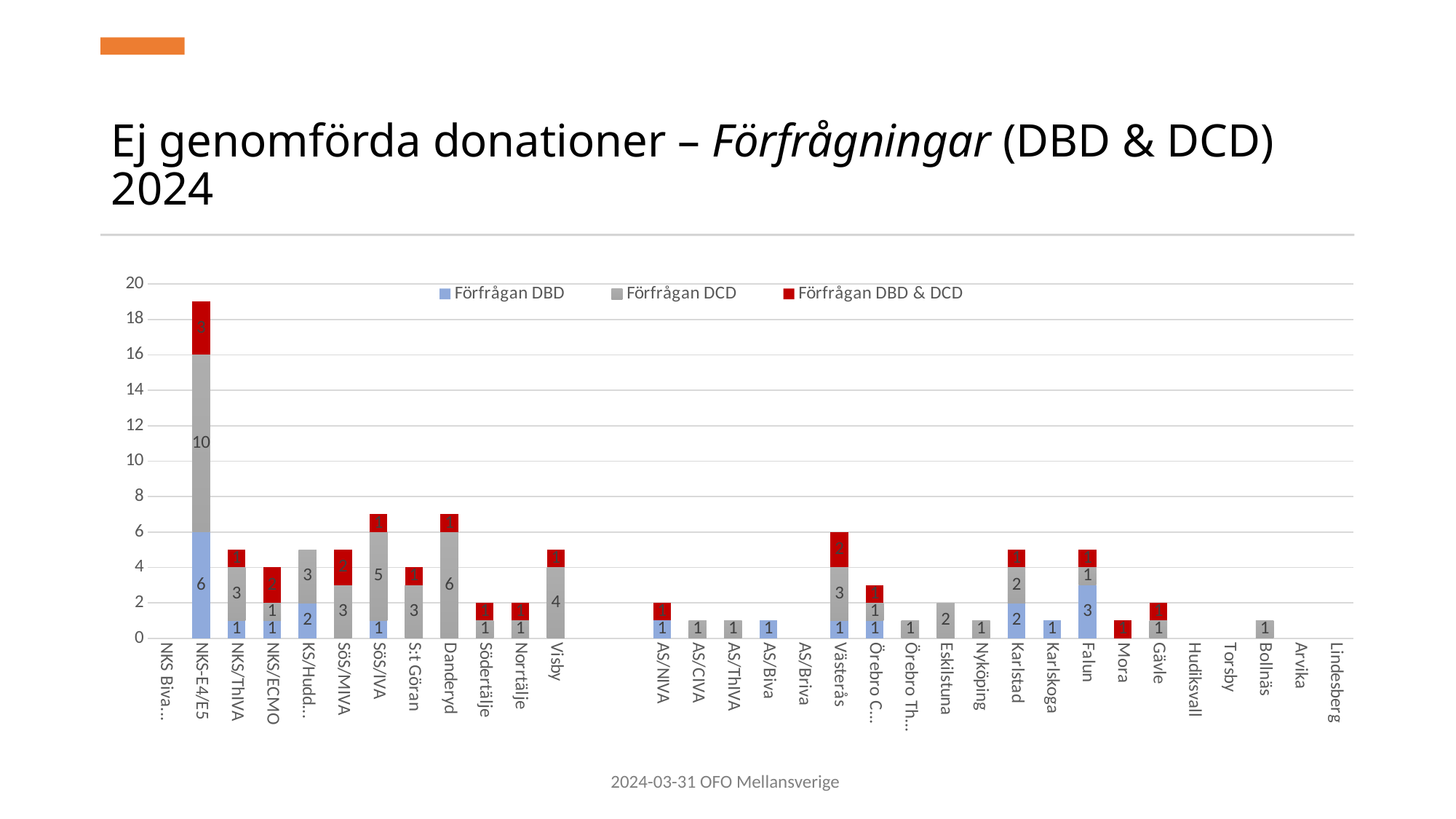
What is the Förfrågan DBD value for Falun? 3 Which has a larger Förfrågan DCD value, Visby or Eskilstuna? Visby What is the Förfrågan DBD & DCD value for Västerås? 2 What is the Förfrågan DCD value for Danderyd? 6 What is the total of the stacked bar for SöS/IVA? 7 What is the total of the stacked bar for NKS-E4/E5? 19 How many series does the legend list? 3 Which category has the highest total bar? NKS-E4/E5 What is the Förfrågan DCD value for NKS-E4/E5? 10 Which colour represents Förfrågan DBD & DCD in the legend? Red What is the difference between the Förfrågan DCD values for NKS-E4/E5 and SöS/IVA? 5 What type of chart is shown on the slide? Stacked bar chart